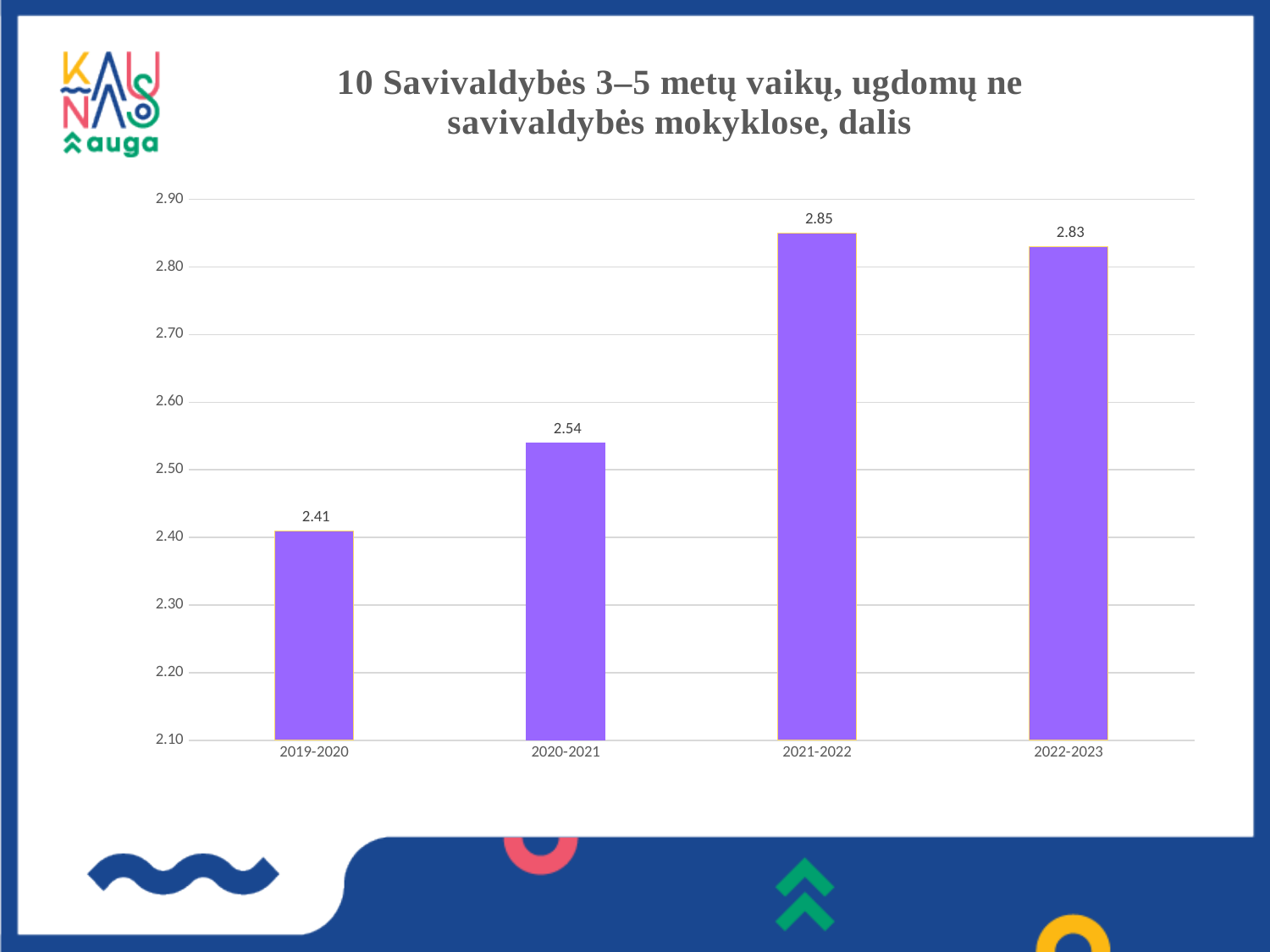
What is the value for 2022-2023? 2.83 What is the title of the chart? 10 Savivaldybės 3–5 metų vaikų, ugdomų ne savivaldybės mokyklose, dalis Which period has the highest value? 2021-2022 What is the difference between the values for 2021-2022 and 2022-2023? 0.02 What kind of chart is shown on the slide? bar chart How many periods are shown on the x axis? 4 What is the difference between the values for 2020-2021 and 2019-2020? 0.13 Which is larger, the value for 2020-2021 or the value for 2022-2023? 2022-2023 What is the value for 2021-2022? 2.85 What is the value for 2019-2020? 2.41 Is the value for 2020-2021 greater or less than 2.50? greater Which period has the lowest value? 2019-2020